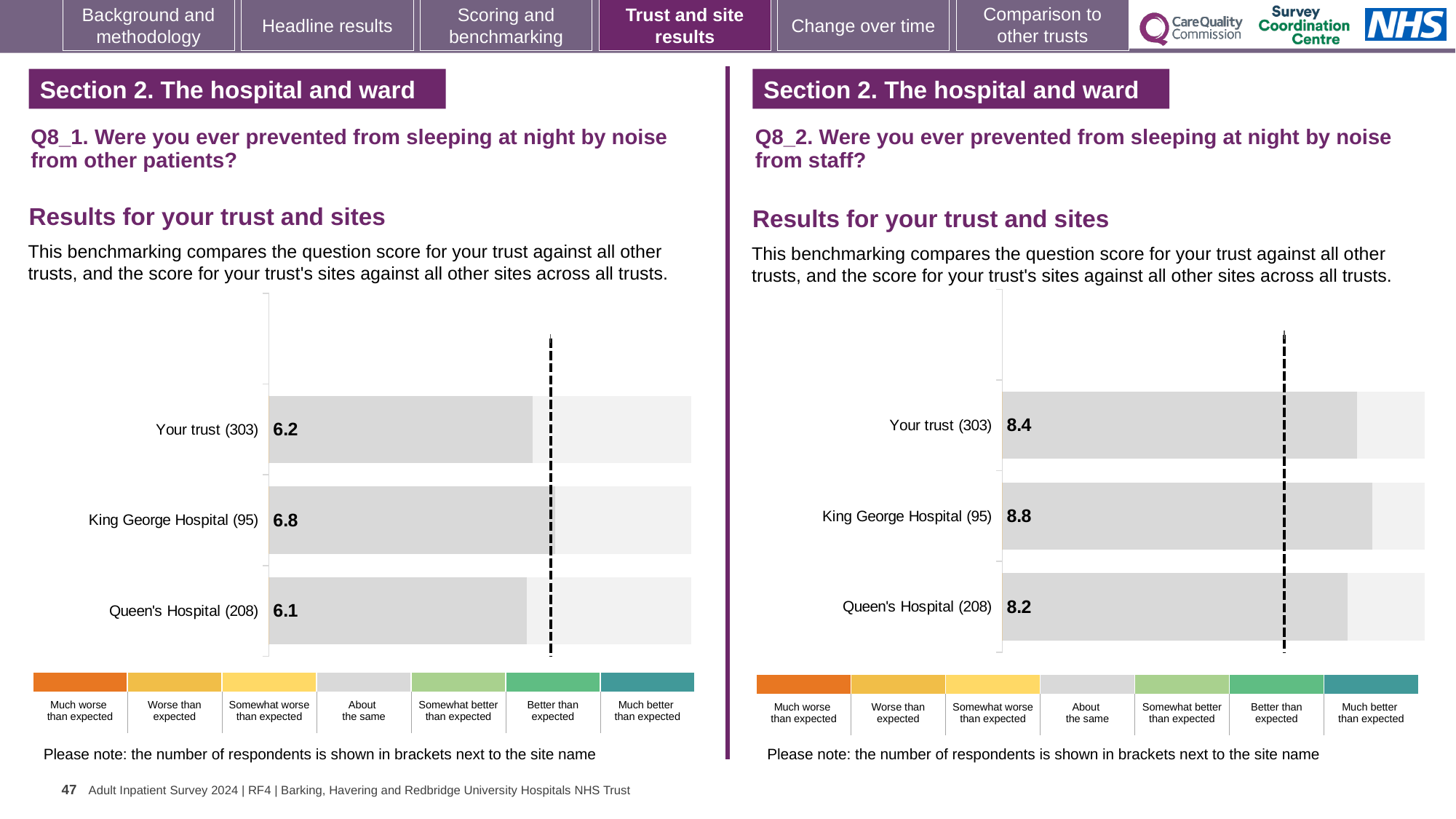
On the Q8_2 chart (right), what is the score for Your trust (303)? 8.4 On the Q8_1 chart (left), what is the score for Your trust (303)? 6.2 What kind of chart is used on the Q8_2 chart (right)? Bar chart On the Q8_2 chart (right), which site or trust has the highest score? King George Hospital (95) On the Q8_2 chart (right), which has the larger score, Your trust (303) or Queen's Hospital (208)? Your trust (303) On the Q8_1 chart (left), what is the difference between the scores for King George Hospital (95) and Queen's Hospital (208)? 0.7 On the Q8_2 chart (right), what is the difference between the scores for King George Hospital (95) and Your trust (303)? 0.4 On the Q8_2 chart (right), what is the score for Queen's Hospital (208)? 8.2 On the Q8_1 chart (left), what is the score for King George Hospital (95)? 6.8 How many categories does the colour key below the Q8_1 chart (left) list? 7 How many bars are plotted on the Q8_1 chart (left)? 3 On the Q8_1 chart (left), which site or trust has the lowest score? Queen's Hospital (208)